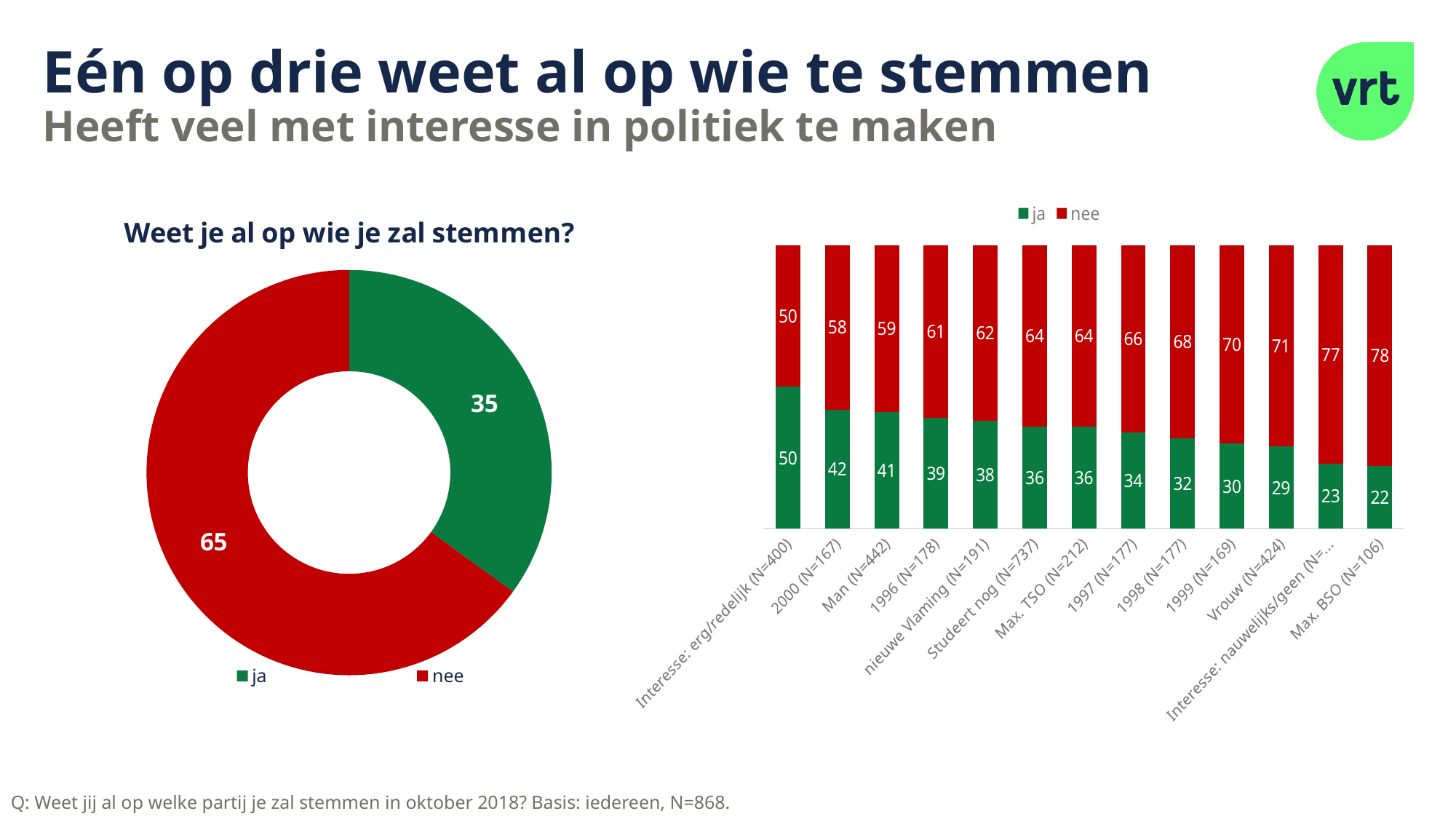
In the stacked bar chart on the right, what is the "nee" value for Vrouw (N=424)? 71 How many series does the legend of the stacked bar chart on the right list? 2 What kind of chart is the chart on the left titled "Weet je al op wie je zal stemmen?"? Donut (pie) chart In the stacked bar chart on the right, which category has the highest "ja" value? Interesse: erg/redelijk (N=400) In the stacked bar chart on the right, what is the "ja" value for Man (N=442)? 41 In the donut chart on the left, what is the value for "nee"? 65 In the stacked bar chart on the right, what is the difference between the "nee" values for Max. BSO (N=106) and Interesse: erg/redelijk (N=400)? 28 In the donut chart on the left, what is the value for "ja"? 35 In the stacked bar chart on the right, which is larger: the "ja" value for 2000 (N=167) or the "ja" value for 1999 (N=169)? 2000 (N=167) How many categories are shown in the stacked bar chart on the right? 13 In the stacked bar chart on the right, what is the total of the stacked bar for Studeert nog (N=737)? 100 In the stacked bar chart on the right, which category has the lowest "ja" value? Max. BSO (N=106)